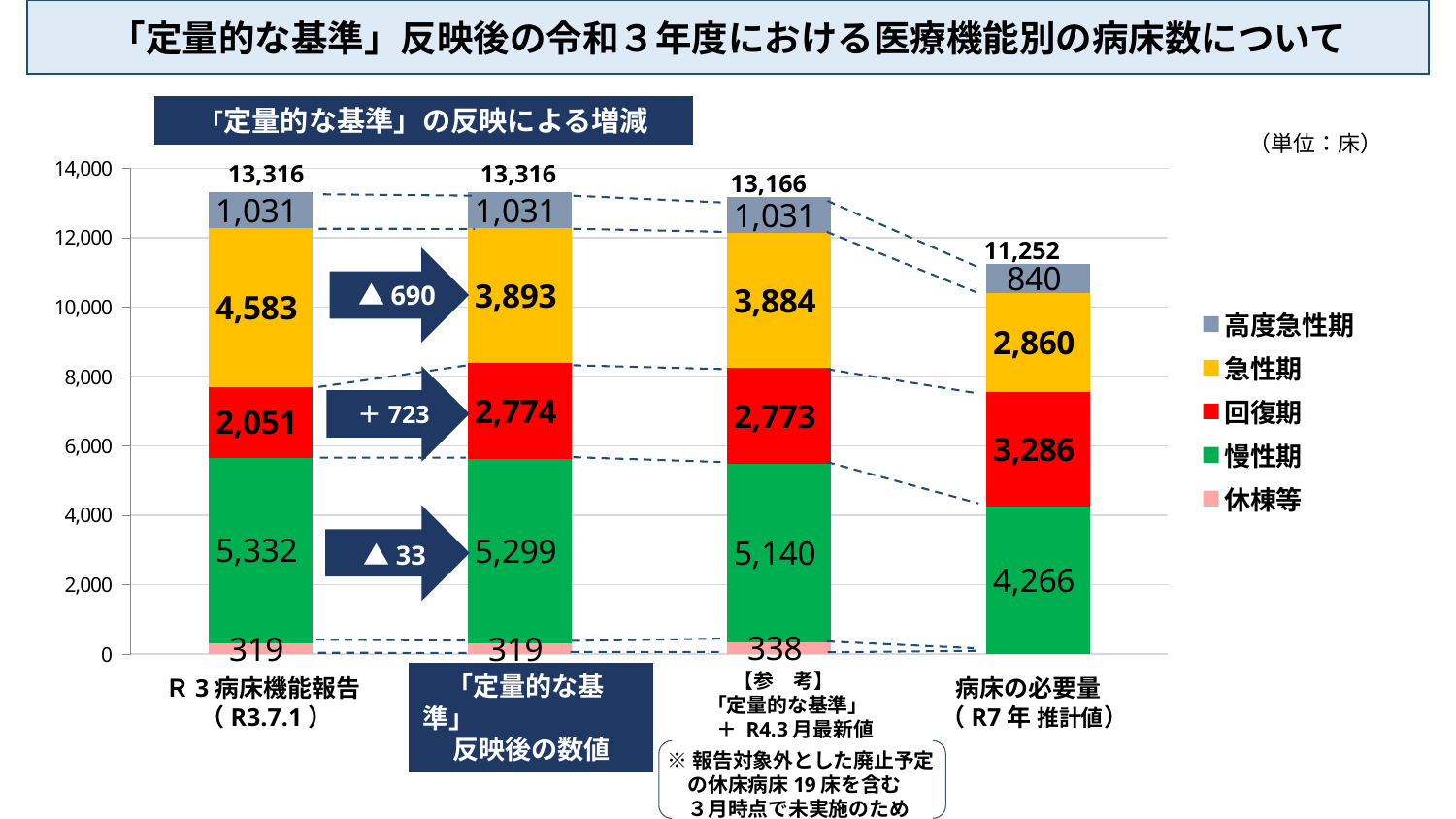
【参考】「定量的な基準」＋R4.3月最新値の棒の合計病床数はいくつですか？ 13,166 凡例で回復期を表す色は何色ですか？ 赤 「定量的な基準」反映後の数値における回復期の病床数はいくつですか？ 2,774 「R３病床機能報告（R3.7.1）」の急性期の病床数はいくつですか？ 4,583 このグラフはどの種類のグラフですか？ 積み上げ棒グラフ 「病床の必要量（R7年推計値）」の慢性期の病床数はいくつですか？ 4,266 横軸にはいくつの区分（棒）がありますか？ 4 凡例にはいくつの系列が示されていますか？ 5 「病床の必要量（R7年推計値）」の棒の合計病床数はいくつですか？ 11,252 4つの区分のうち、合計病床数が最も少ないのはどれですか？ 病床の必要量（R7年推計値） 「R３病床機能報告（R3.7.1）」の慢性期と「病床の必要量（R7年推計値）」の慢性期では、どちらの病床数が多いですか？ R３病床機能報告（R3.7.1） 「R３病床機能報告（R3.7.1）」と「定量的な基準」反映後の数値で、急性期の病床数の差はいくつですか？ 690